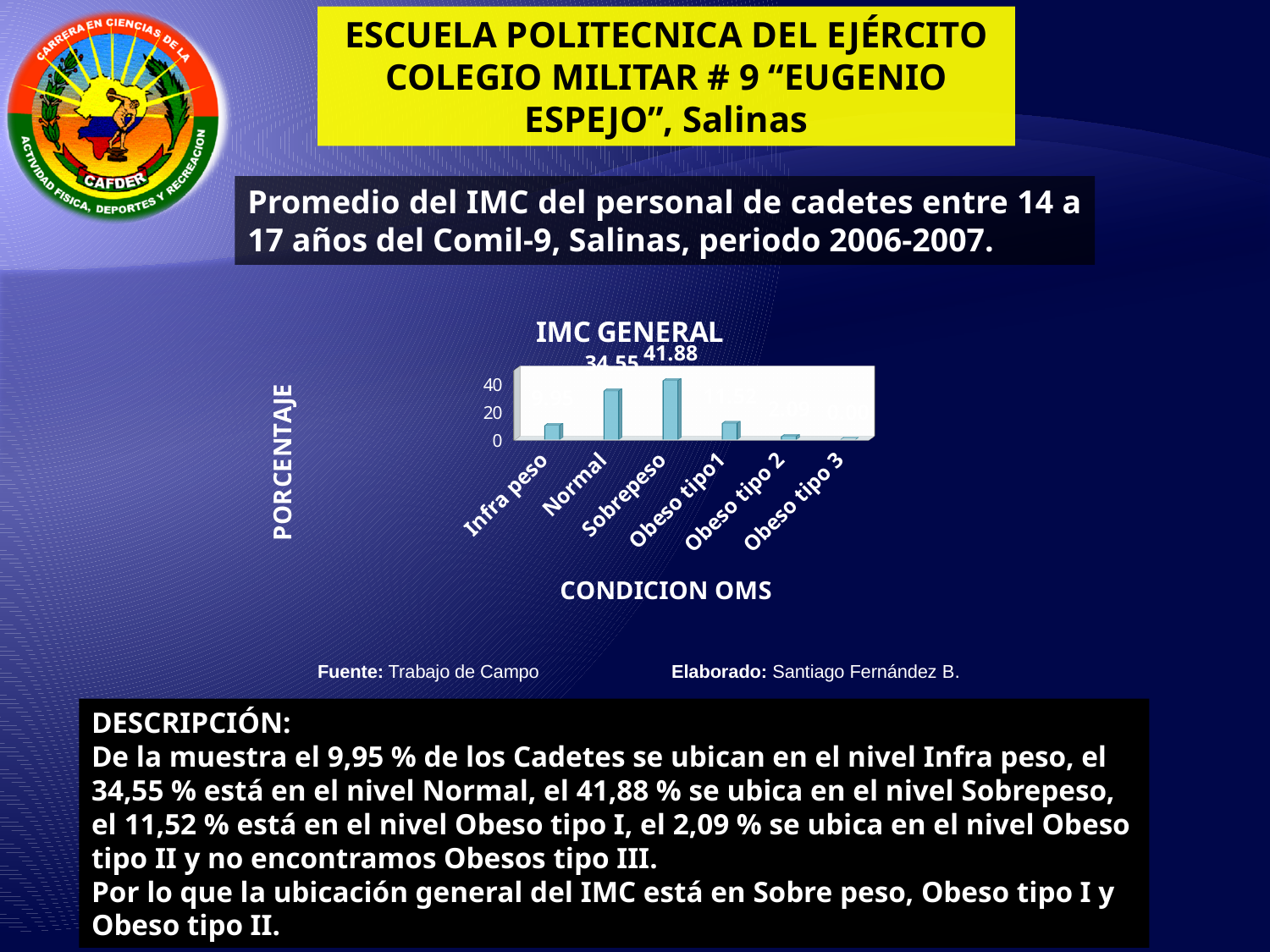
Which category has the highest bar in the IMC GENERAL chart? Sobrepeso What is the value shown for Sobrepeso in the IMC GENERAL chart? 41.88 Which is larger in the IMC GENERAL chart, the bar for Normal or the bar for Infra peso? Normal What is the value shown for Normal in the IMC GENERAL chart? 34.55 What is the difference between the values for Sobrepeso and Normal in the IMC GENERAL chart? 7.33 Is the value for Obeso tipo1 greater or less than 20 in the IMC GENERAL chart? less Is the value for Normal greater or less than 20 in the IMC GENERAL chart? greater Is the value for Infra peso greater or less than 20 in the IMC GENERAL chart? less Which category has the lowest bar in the IMC GENERAL chart? Obeso tipo 3 What is the title of the x axis of the IMC GENERAL chart? CONDICION OMS How many categories are shown on the x axis of the IMC GENERAL chart? 6 What kind of chart is the IMC GENERAL chart? Bar chart